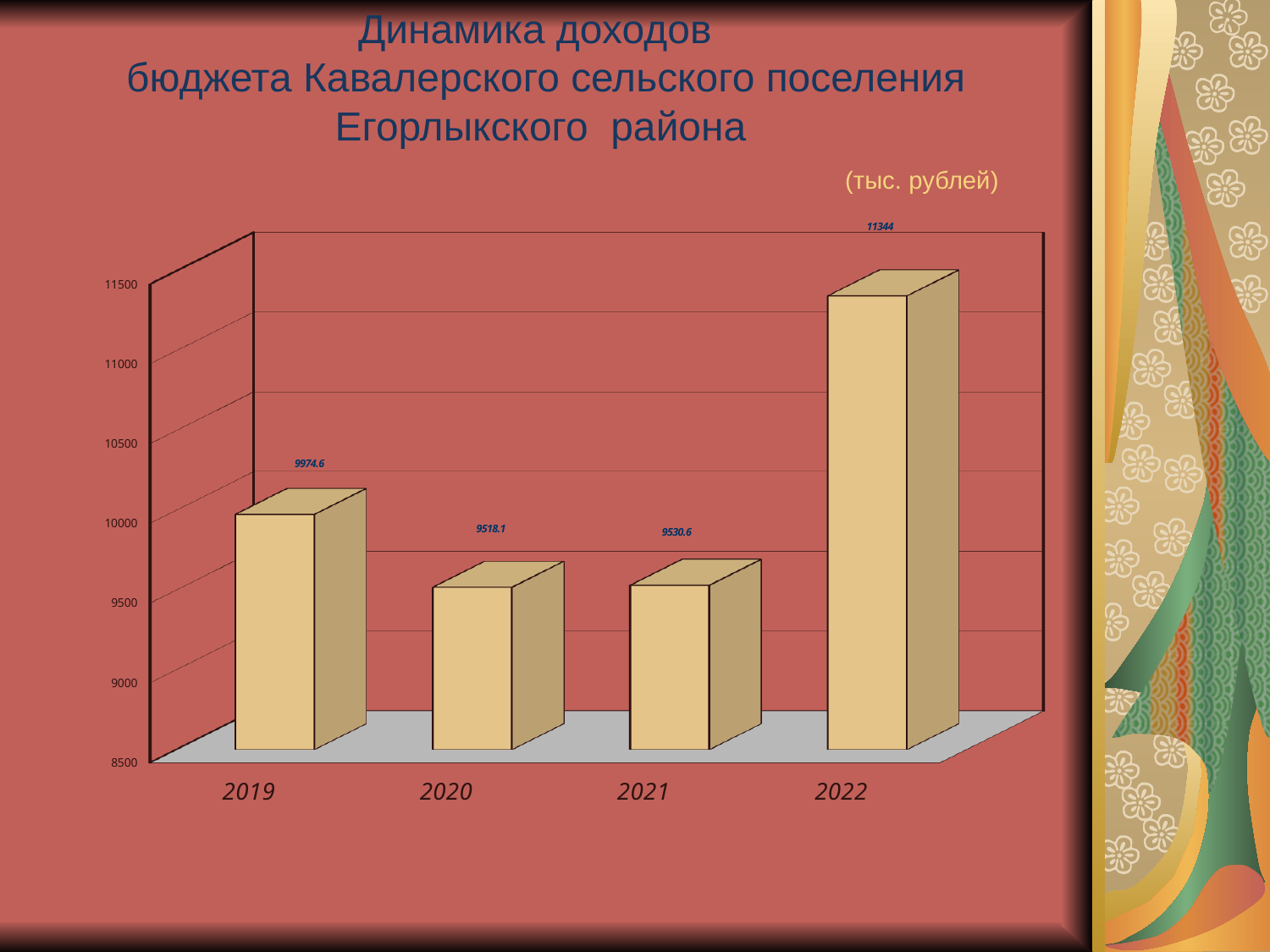
What is the value for 2022? 11344 What is the difference between the values for 2022 and 2019? 1369.4 What is the value for 2019? 9974.6 Does the value rise or fall from 2021 to 2022? rise What is the value for 2021? 9530.6 Which year has the highest value? 2022 What kind of chart is shown on the slide? bar chart Which is larger, the value for 2019 or the value for 2021? 2019 What is the value for 2020? 9518.1 How many years are shown on the x axis? 4 Which year has the lowest value? 2020 What is the difference between the values for 2021 and 2020? 12.5